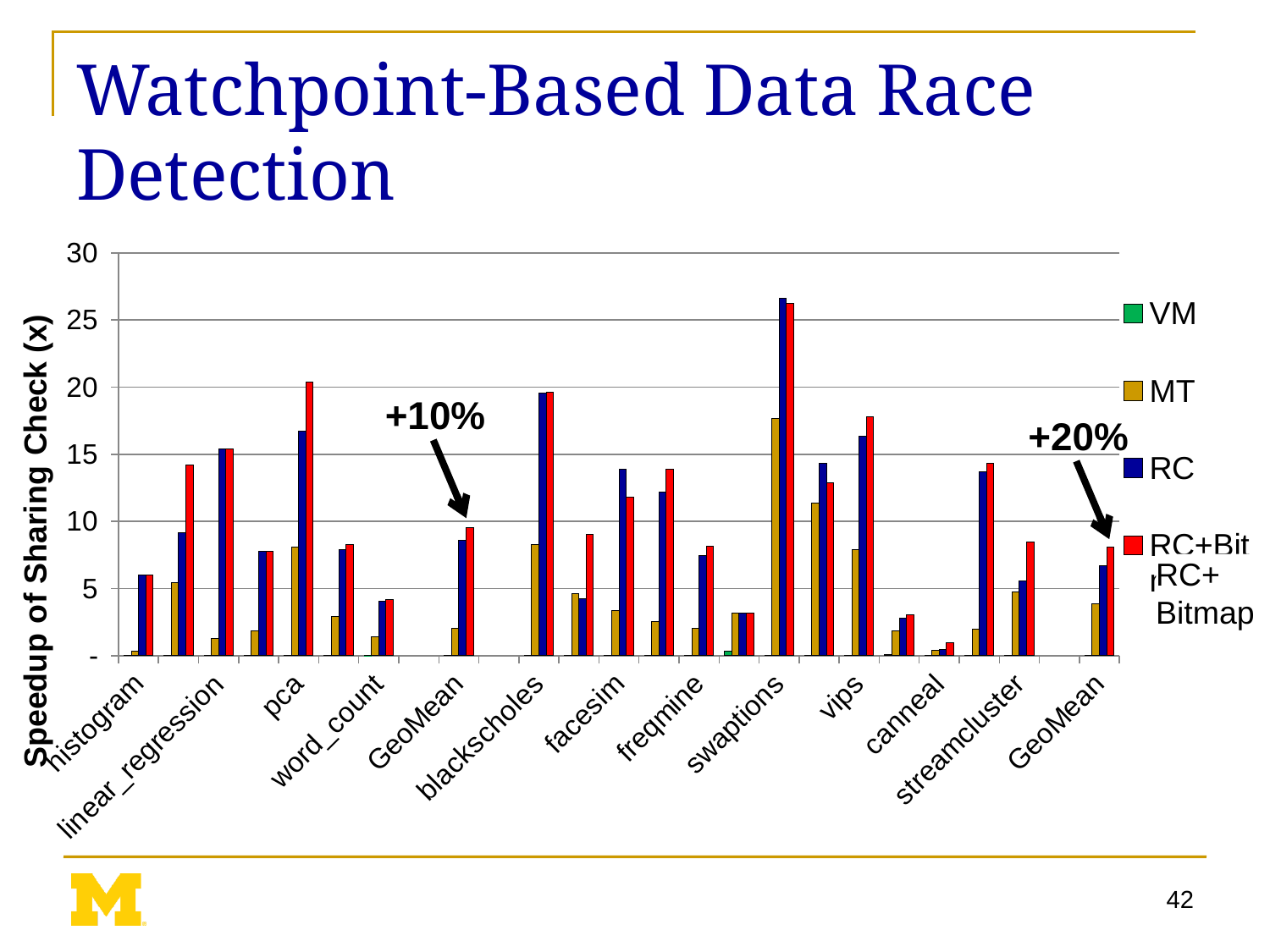
Which category has the lowest RC value? canneal Is the RC value for word_count greater or less than 10? less Which category has the highest RC+Bitmap value? swaptions What kind of chart is shown on the slide? bar chart Is the MT value for swaptions greater or less than 15? greater How many series does the legend list? 4 For facesim, which is larger: the RC value or the RC+Bitmap value? RC Is the RC value for blackscholes greater or less than 15? greater What is the label on the y axis of the chart? Speedup of Sharing Check (x)